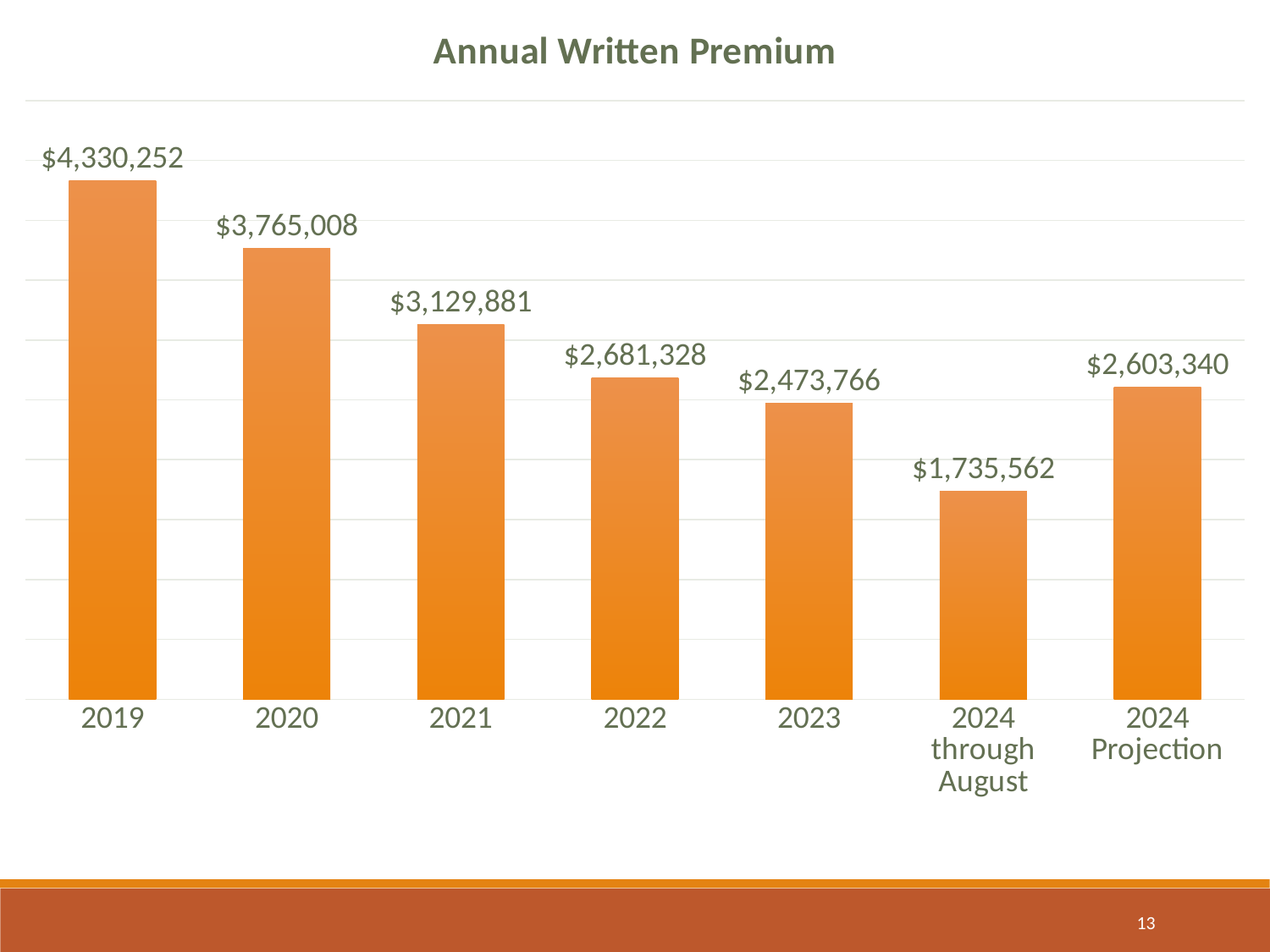
How many categories are shown on the x axis? 7 Do the annual written premium values rise or fall from 2019 to 2023? Fall What is the value shown for 2024 through August? $1,735,562 Which is larger, the annual written premium for 2021 or for 2023? 2021 What is the annual written premium for 2019? $4,330,252 What is the annual written premium for 2022? $2,681,328 Which category has the lowest annual written premium? 2024 through August What kind of chart is shown on the slide? Bar chart Which category has the highest annual written premium? 2019 How much higher is the 2024 Projection than the 2024 through August value? $867,778 What is the value shown for the 2024 Projection? $2,603,340 What is the difference between the 2019 and 2020 annual written premiums? $565,244